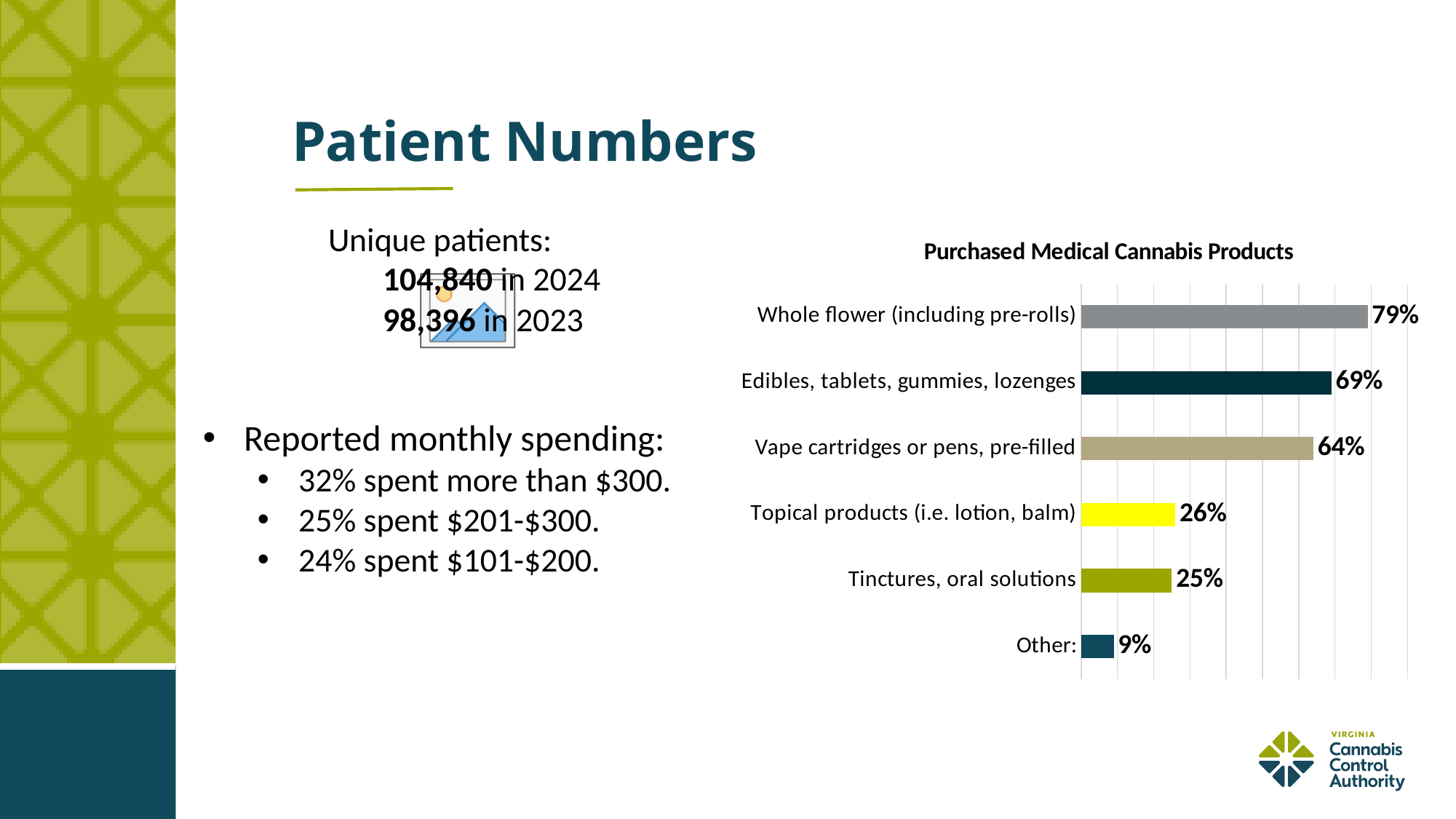
Which is larger: the value for topical products (i.e. lotion, balm) or tinctures, oral solutions? Topical products (i.e. lotion, balm) What is the difference between the values for vape cartridges or pens, pre-filled and topical products (i.e. lotion, balm)? 38% What is the difference between the percentages for whole flower (including pre-rolls) and edibles, tablets, gummies, lozenges? 10% What percentage is shown for vape cartridges or pens, pre-filled? 64% What is the value for edibles, tablets, gummies, lozenges? 69% Which product category has the highest percentage? Whole flower (including pre-rolls) Which product category has the lowest percentage? Other: What is the value for tinctures, oral solutions? 25% How many product categories are shown in the chart? 6 What kind of chart is shown on the slide? Bar chart What percentage of patients purchased whole flower (including pre-rolls)? 79% What is the title of the chart? Purchased Medical Cannabis Products